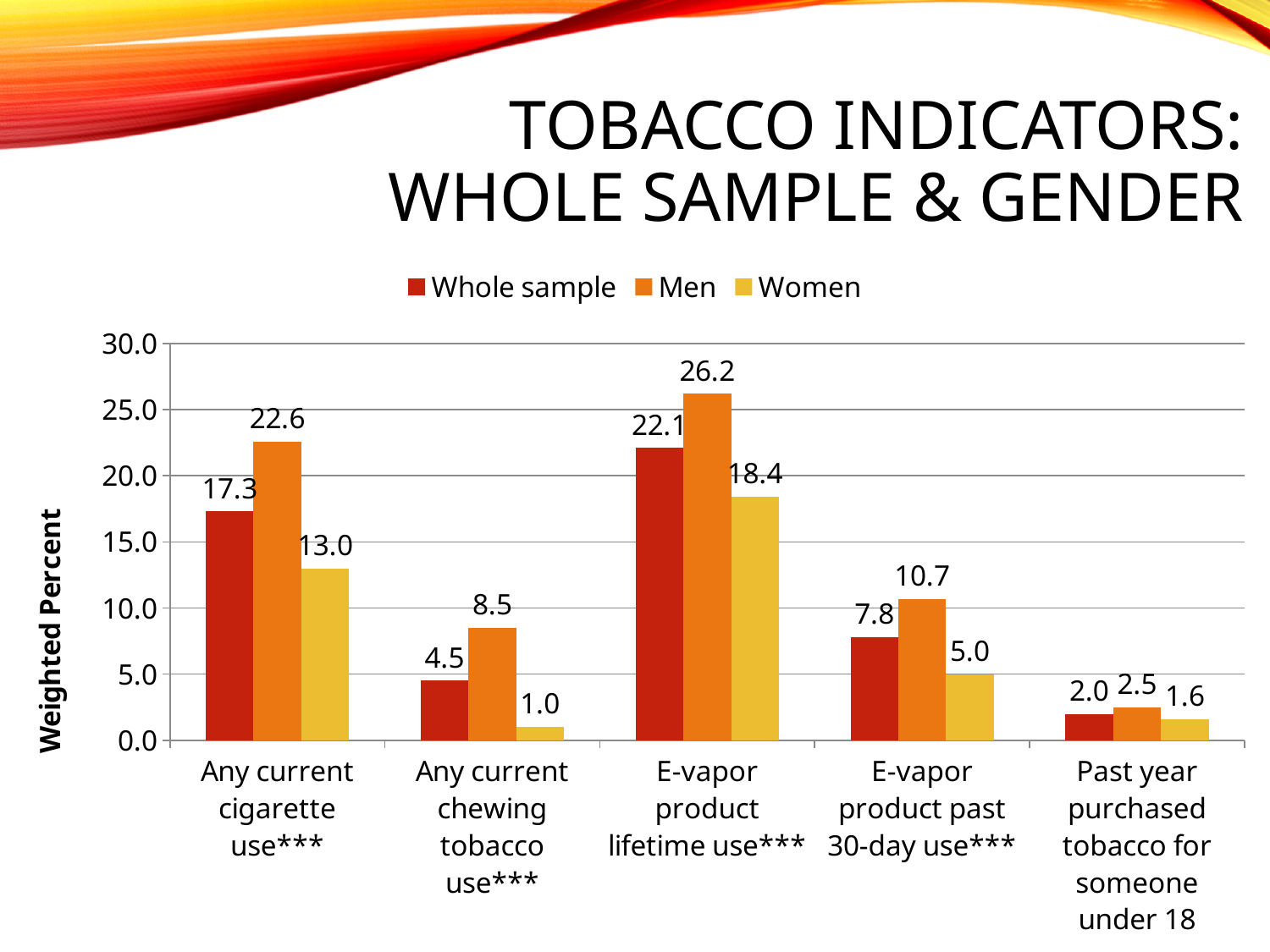
How many series does the legend list? 3 How many categories are shown on the x axis? 5 Which category has the lowest value for Women? Any current chewing tobacco use Which is larger for Any current chewing tobacco use: the Men value or the Whole sample value? Men What is the label of the y axis? Weighted Percent What is the value for Women for E-vapor product lifetime use? 18.4 What is the difference between the Men and Women values for E-vapor product past 30-day use? 5.7 Which category has the highest value for Men? E-vapor product lifetime use What is the difference between the Men and Women values for Any current cigarette use? 9.6 What is the value for Men for Any current cigarette use? 22.6 What kind of chart is shown? Bar chart What is the Whole sample value for E-vapor product past 30-day use? 7.8